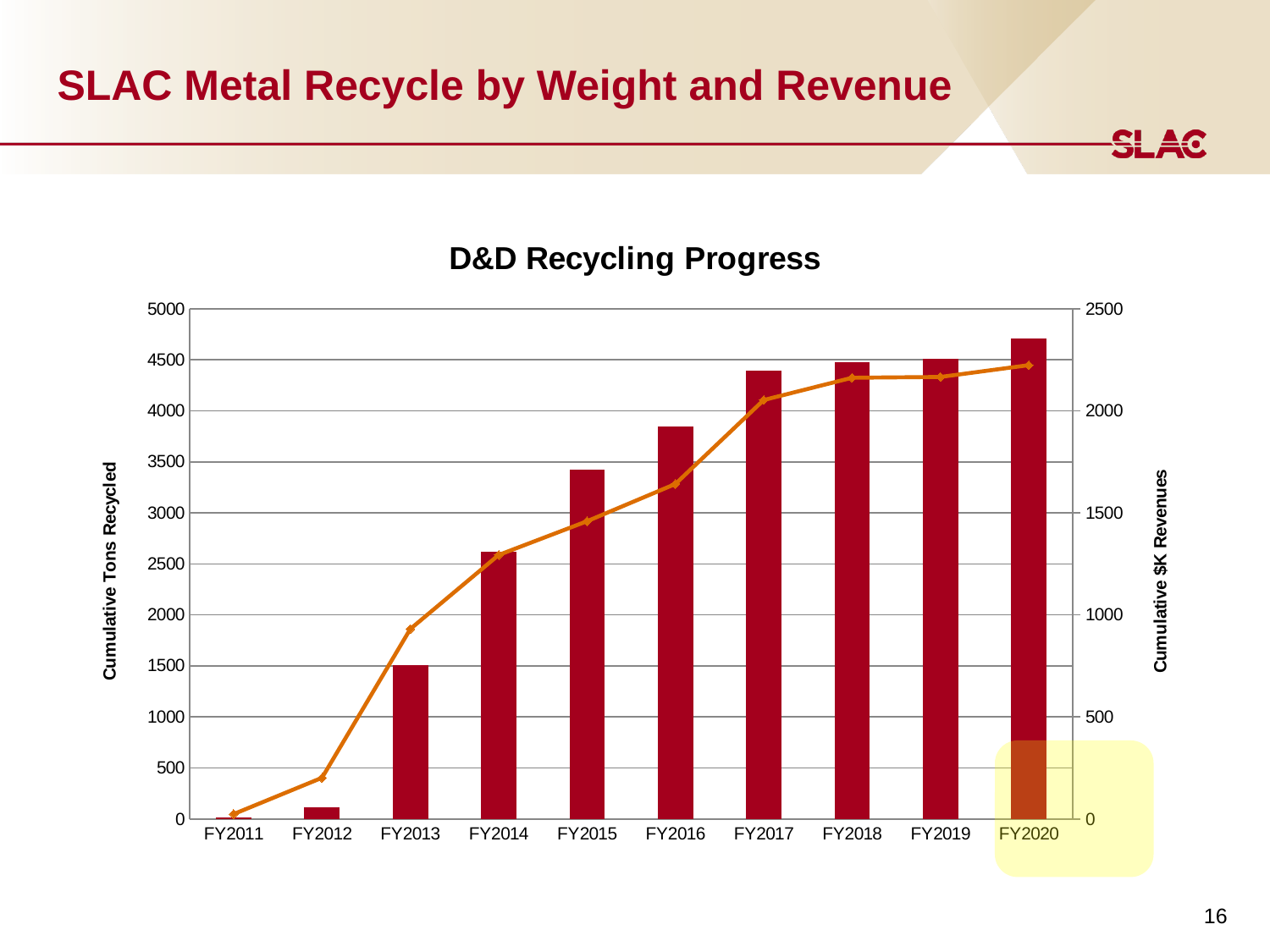
Is the Cumulative $K Revenues line value for FY2013 greater or less than 1000? less What is the title of the chart? D&D Recycling Progress How many fiscal years are shown on the x axis of the chart? 10 Is the Cumulative Tons Recycled bar for FY2014 greater or less than 3000? less What is the label on the right-hand vertical axis of the chart? Cumulative $K Revenues Which fiscal year has the shortest bar for Cumulative Tons Recycled? FY2011 Which has the taller Cumulative Tons Recycled bar, FY2015 or FY2016? FY2016 Which fiscal year has the tallest bar for Cumulative Tons Recycled? FY2020 Is the Cumulative $K Revenues line value for FY2017 greater or less than 2000? greater Do the Cumulative Tons Recycled bars rise or fall from FY2011 to FY2020? Rise What kind of chart is shown on the slide? Combined bar and line chart